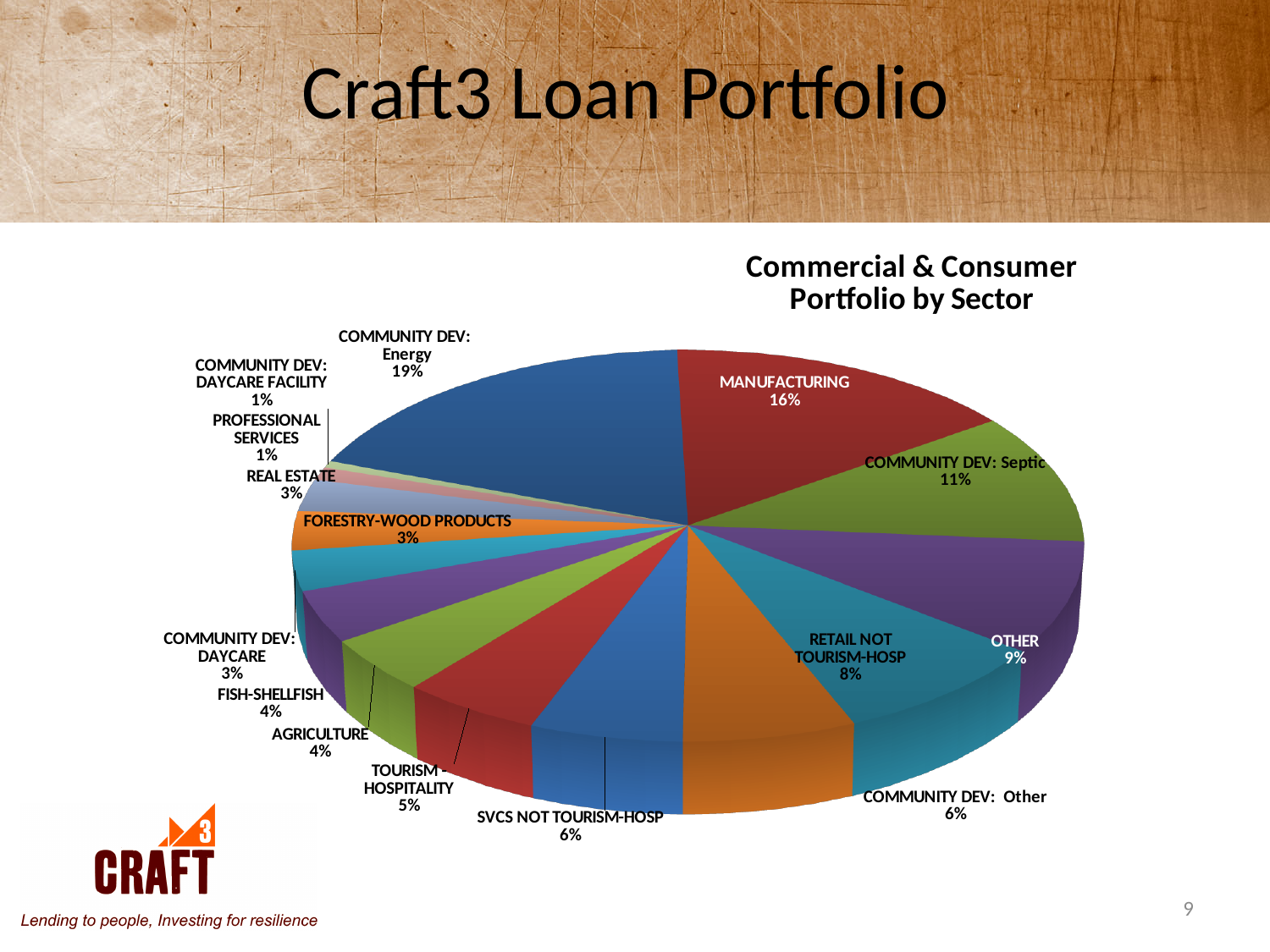
What percentage is shown for RETAIL NOT TOURISM-HOSP? 8% How many sectors are shown in the pie chart? 15 What kind of chart is shown on the slide? pie chart What is the title of the chart? Commercial & Consumer Portfolio by Sector Which sector has the largest share of the portfolio? COMMUNITY DEV: Energy What percentage is shown for REAL ESTATE? 3% What share of the portfolio is MANUFACTURING? 16% Which is larger, OTHER or COMMUNITY DEV: Other? OTHER What percentage is shown for COMMUNITY DEV: Septic? 11% What percentage is shown for TOURISM - HOSPITALITY? 5% What is the difference in percentage points between COMMUNITY DEV: Septic and AGRICULTURE? 7 What is the difference in percentage points between COMMUNITY DEV: Energy and MANUFACTURING? 3